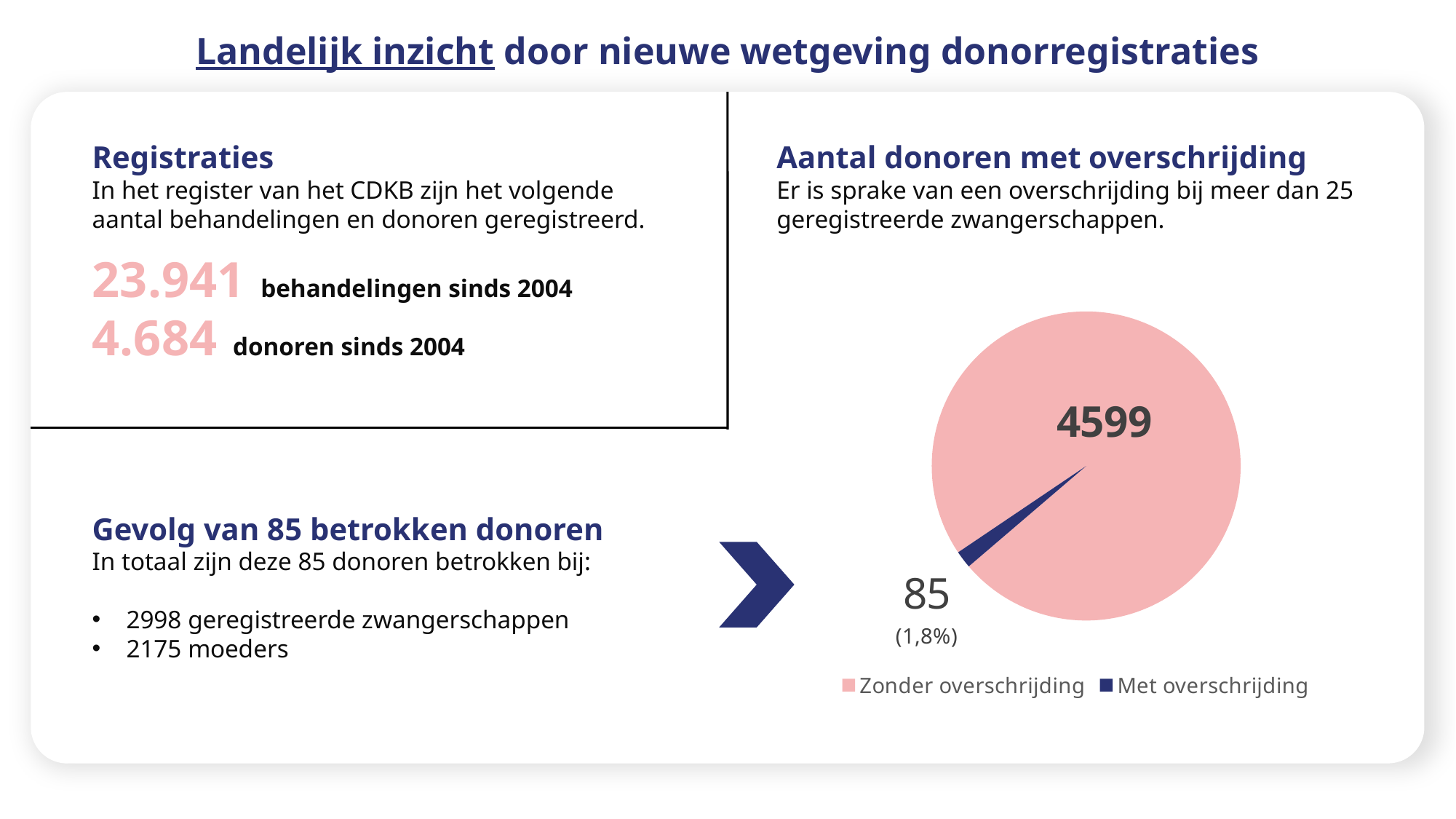
How many entries does the pie chart legend list? 2 Which is larger in the pie chart: "Zonder overschrijding" or "Met overschrijding"? Zonder overschrijding What colour is the "Met overschrijding" slice in the pie chart? dark blue What is the difference between the "Zonder overschrijding" and "Met overschrijding" values in the pie chart? 4514 What is the value for "Met overschrijding" in the pie chart? 85 How many slices does the pie chart have? 2 What share of the pie does "Met overschrijding" represent, as printed on the slide? 1,8% Which slice of the pie chart is the largest? Zonder overschrijding What is the value for "Zonder overschrijding" in the pie chart? 4599 Which slice of the pie chart is the smallest? Met overschrijding What is the total of the two values shown in the pie chart? 4684 What kind of chart is shown on the slide? pie chart